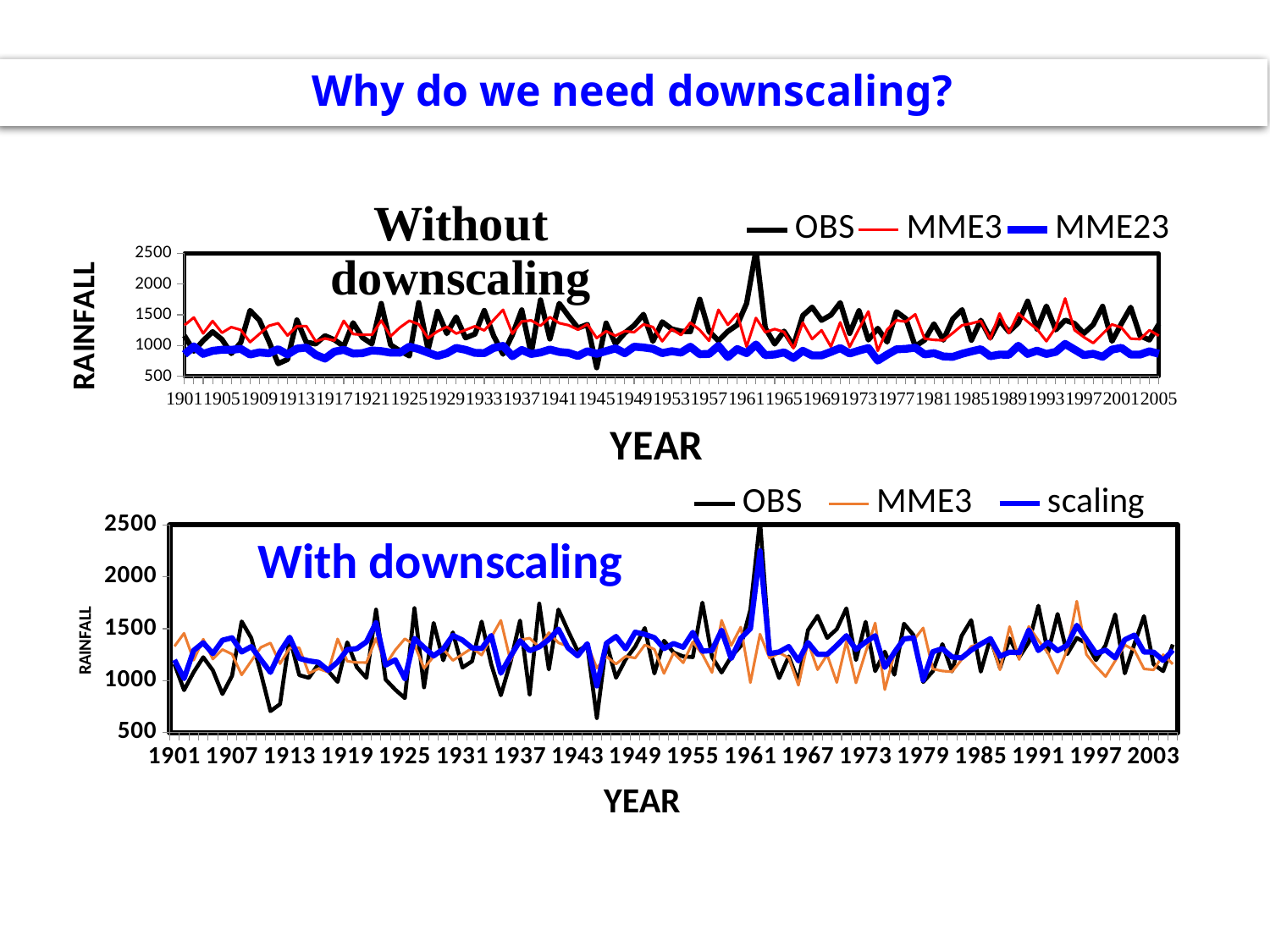
In the 'With downscaling' chart, is the peak 'scaling' value around 1961 greater or less than 2000? greater How many series does the legend of the 'Without downscaling' chart list? 3 In the 'With downscaling' chart, which series reaches the lowest value? OBS In the 'Without downscaling' chart, is the MME23 value for 1961 greater or less than 1000? less What kind of chart is the 'With downscaling' chart at the bottom of the slide? line chart What kind of chart is the 'Without downscaling' chart at the top of the slide? line chart In the 'Without downscaling' chart, is the peak OBS value around 1961 greater or less than 2000? greater What are the legend entries of the 'Without downscaling' chart? OBS, MME3, MME23 What are the legend entries of the 'With downscaling' chart? OBS, MME3, scaling In the 'Without downscaling' chart, which series reaches the highest value? OBS How many series does the legend of the 'With downscaling' chart list? 3